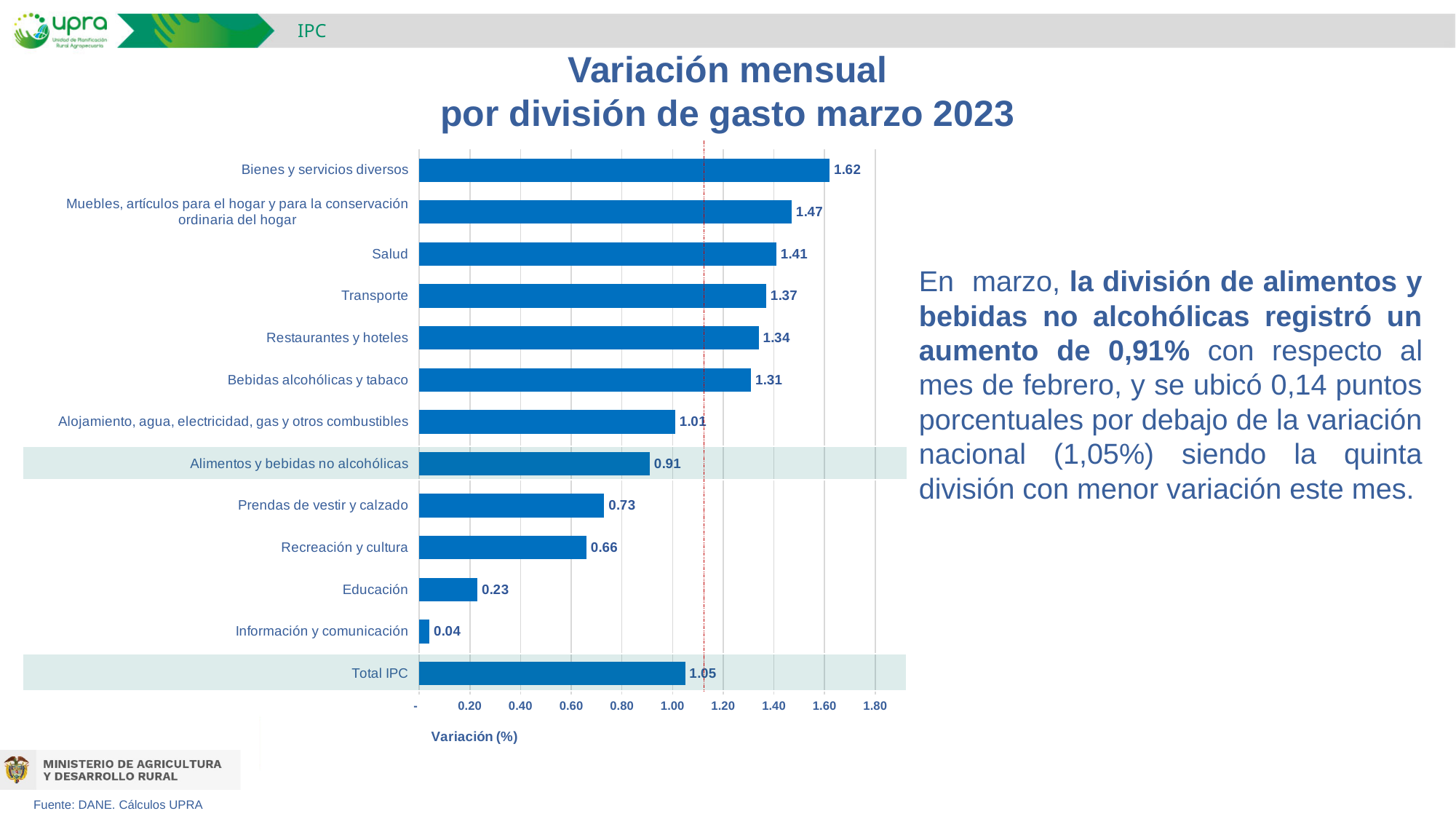
Which category has the lowest value? Información y comunicación What is the difference between the values for Bienes y servicios diversos and Educación? 1.39 What kind of chart is shown on the slide? bar chart How many categories are shown on the chart? 13 What is the title of the chart? Variación mensual por división de gasto marzo 2023 Which is larger, the value for Transporte or the value for Restaurantes y hoteles? Transporte What is the value for Total IPC? 1.05 What is the value for Salud? 1.41 What is the label of the horizontal axis? Variación (%) Is the value for Prendas de vestir y calzado greater or less than 0.80? less Which category has the highest value? Bienes y servicios diversos What is the value for Alimentos y bebidas no alcohólicas? 0.91